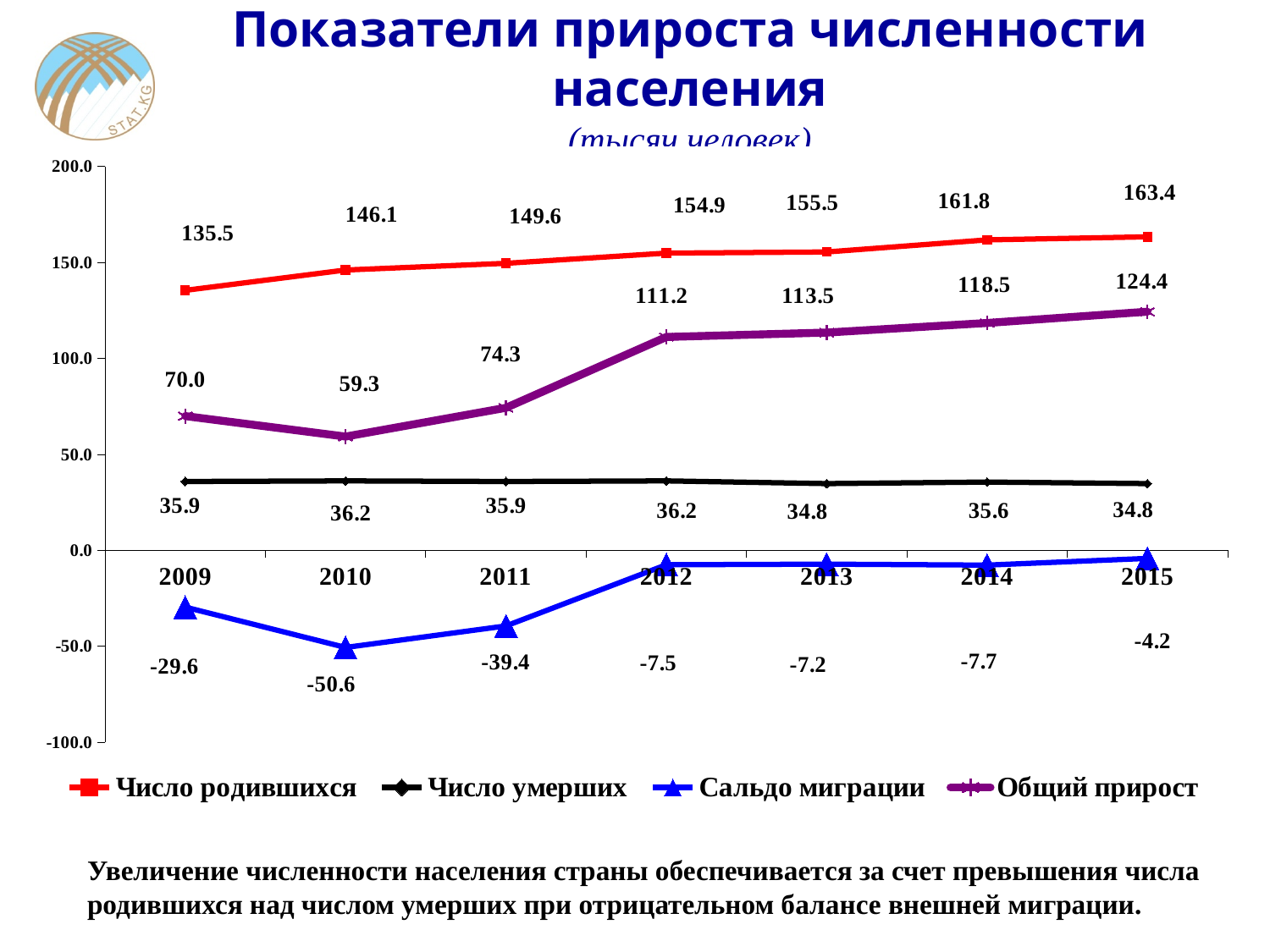
What is the value of Число родившихся in 2012? 154.9 In which year is Сальдо миграции lowest? 2010 What type of chart is shown on the slide? line chart Does Число родившихся rise or fall from 2009 to 2015? rise How many series does the legend list? 4 What is the value of Общий прирост in 2010? 59.3 In which year is Число родившихся highest? 2015 Which is larger in 2009: Общий прирост or Число умерших? Общий прирост Which series is drawn in red? Число родившихся What is the value of Сальдо миграции in 2011? -39.4 How many years are plotted along the x axis? 7 What is the difference between Число родившихся and Число умерших in 2015? 128.6